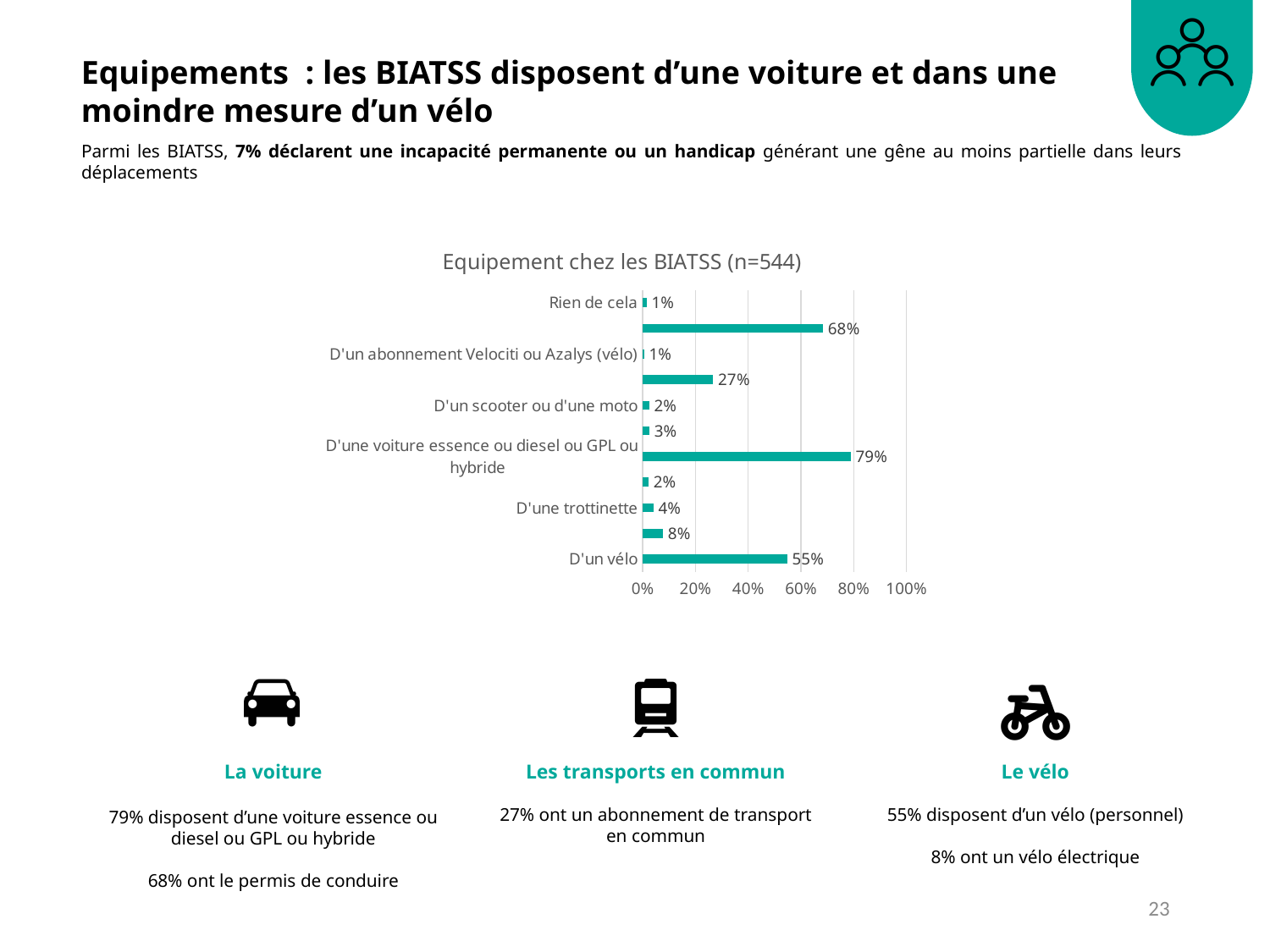
What is the value for 'D'une trottinette' in the chart? 4% How many bars are plotted in the chart? 11 What is the difference between the value for 'D'une voiture essence ou diesel ou GPL ou hybride' and the value for 'D'un vélo'? 24 percentage points Which category has the highest value in the chart? D'une voiture essence ou diesel ou GPL ou hybride What is the value for 'Rien de cela' in the chart? 1% What is the title of the chart? Equipement chez les BIATSS (n=544) What is the value for 'D'un abonnement Velociti ou Azalys (vélo)' in the chart? 1% Is the value for 'D'un vélo' greater or less than 40%? greater What is the value for 'D'un vélo' in the chart? 55% What is the value for 'D'un scooter ou d'une moto' in the chart? 2% Which has the larger value: 'D'un vélo' or 'D'une trottinette'? D'un vélo What is the value for 'D'une voiture essence ou diesel ou GPL ou hybride' in the chart? 79%